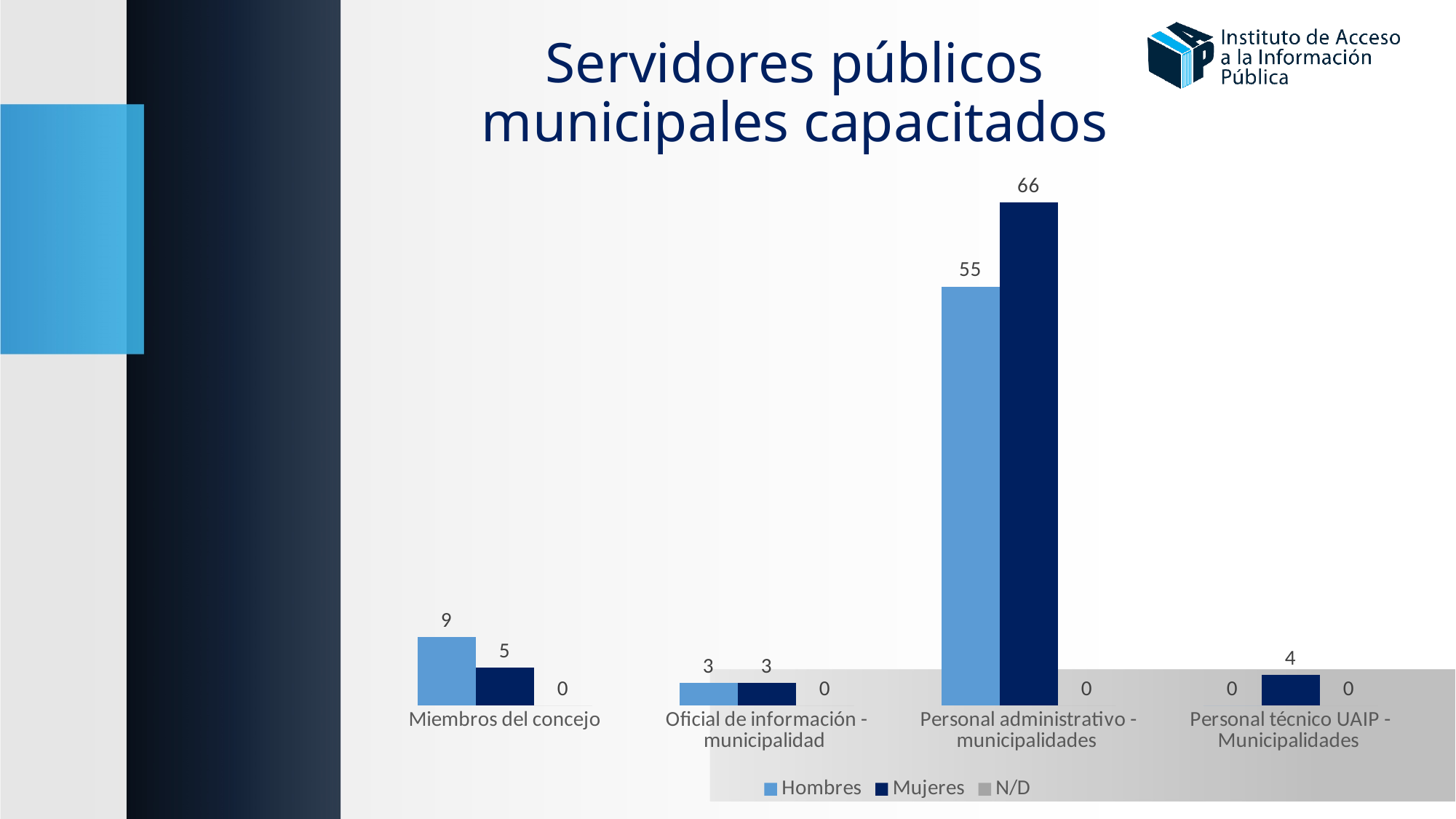
What is the value for Mujeres in the Personal administrativo - municipalidades category? 66 Which category has the lowest Hombres value? Personal técnico UAIP - Municipalidades Which is larger in the Miembros del concejo category, Hombres or Mujeres? Hombres What kind of chart is shown on the slide? Bar chart What is the value for Hombres in the Miembros del concejo category? 9 What is the difference between the Mujeres and Hombres values in the Personal administrativo - municipalidades category? 11 What is the value for Hombres in the Personal administrativo - municipalidades category? 55 How many series does the legend list? 3 How many categories are shown on the x axis? 4 What is the value for N/D in the Oficial de información - municipalidad category? 0 Which category has the highest Mujeres value? Personal administrativo - municipalidades What is the value for Mujeres in the Personal técnico UAIP - Municipalidades category? 4